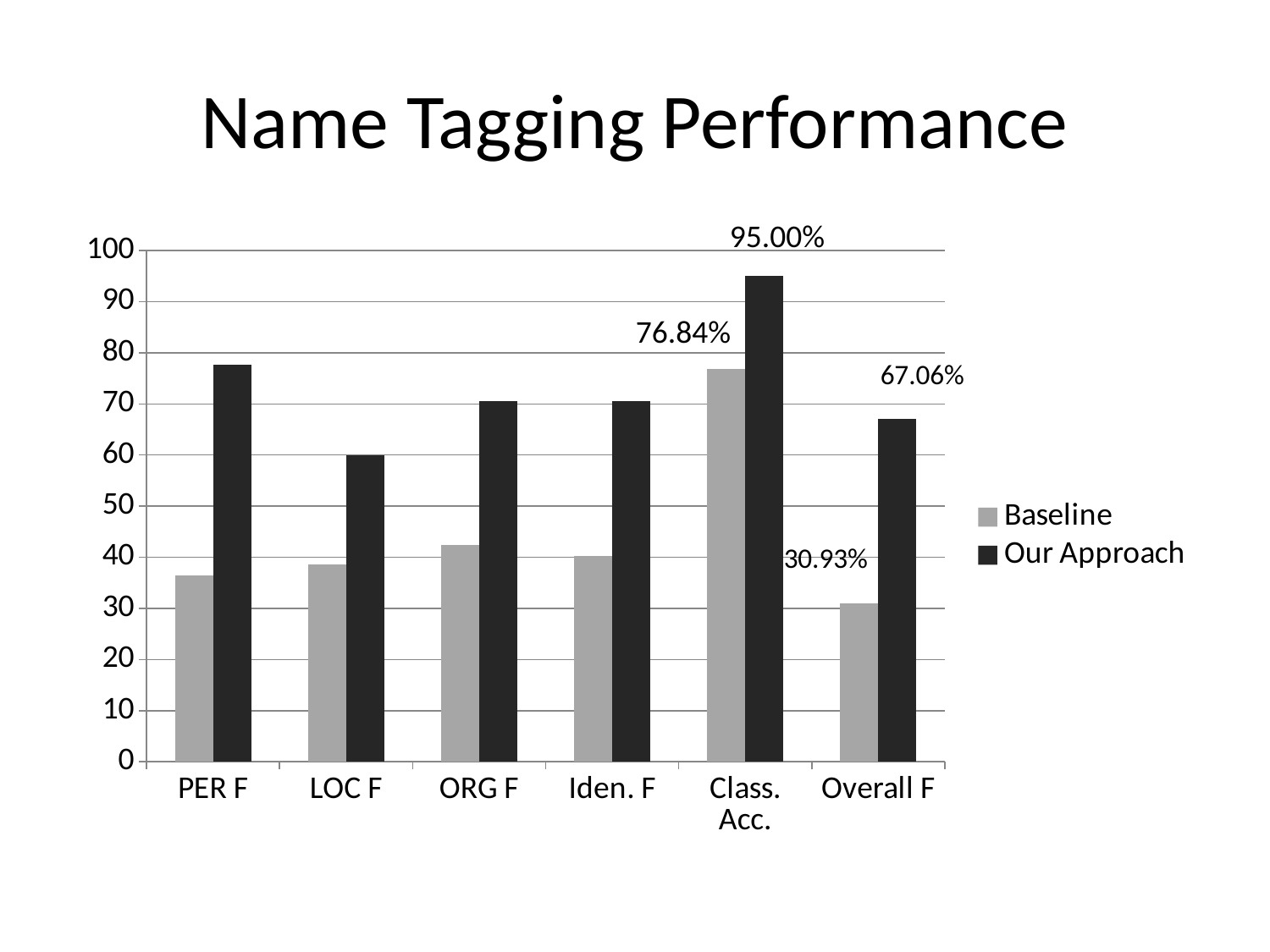
How many categories are shown on the x axis? 6 What is the Baseline value for Overall F? 30.93% What is the title of the chart? Name Tagging Performance Which category has the lowest Baseline value? Overall F What is the Our Approach value for Overall F? 67.06% Is the Baseline value for PER F greater or less than 40? less By how many percentage points does Our Approach exceed Baseline for Overall F? 36.13 Which category has the highest Our Approach value? Class. Acc. What type of chart is shown on the slide? bar chart What is the Our Approach value for Class. Acc.? 95.00% How many series does the legend list? 2 What is the Baseline value for Class. Acc.? 76.84%